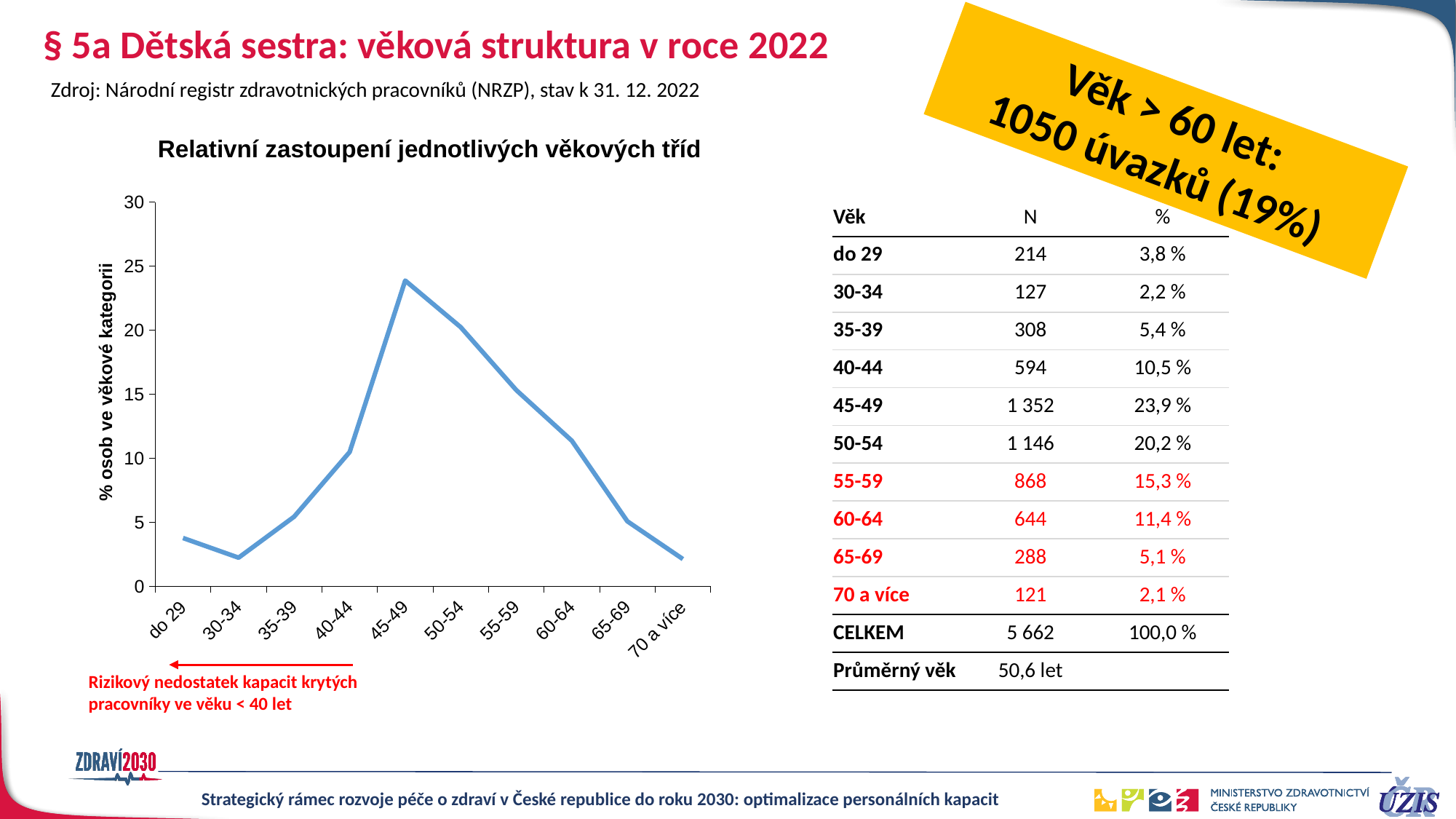
Which has a larger value in the chart, 45-49 or 50-54? 45-49 Is the value for 45-49 greater or less than 20? greater Is the value for 40-44 greater or less than 15? less How many age categories are plotted along the x axis of the chart? 10 Which age category has the highest value in the chart? 45-49 Is the value for 60-64 greater or less than 10? greater What is the title of the chart? Relativní zastoupení jednotlivých věkových tříd Which has a larger value in the chart, 55-59 or 35-39? 55-59 Do the values rise or fall along the x axis from 45-49 to 70 a více? fall What kind of chart is shown on the slide? line chart